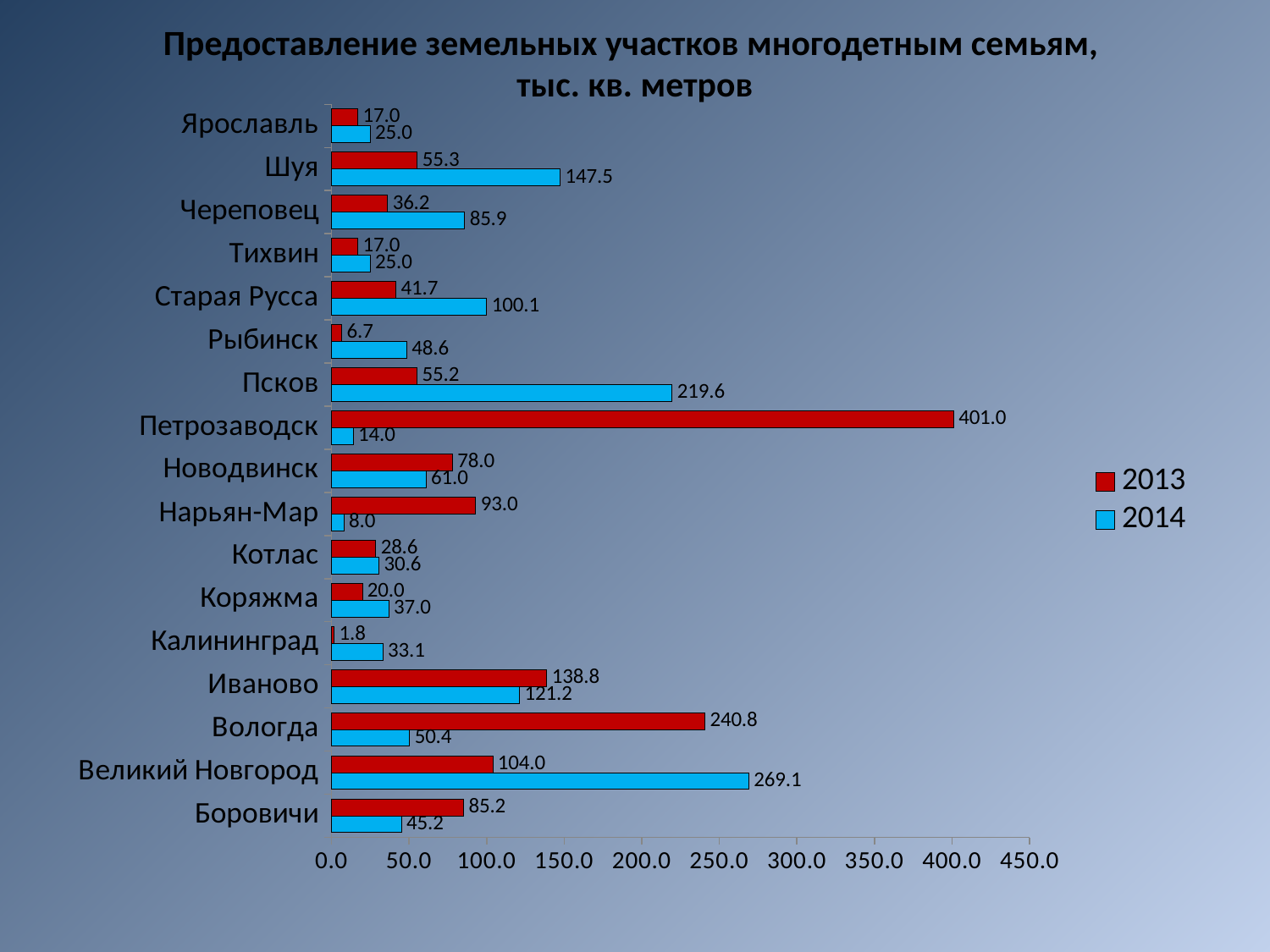
How many series does the legend list? 2 Which city has the highest 2013 value? Петрозаводск For Вологда, which year has the larger value, 2013 or 2014? 2013 How many cities are shown on the chart? 17 Which city has the lowest 2013 value? Калининград What is the difference between the 2013 and 2014 values for Петрозаводск? 387.0 What is the 2014 value for Великий Новгород? 269.1 Which city has the lowest 2014 value? Нарьян-Мар What is the 2013 value for Петрозаводск? 401.0 What is the 2014 value for Псков? 219.6 What is the difference between the 2014 and 2013 values for Шуя? 92.2 Which city has the highest 2014 value? Великий Новгород